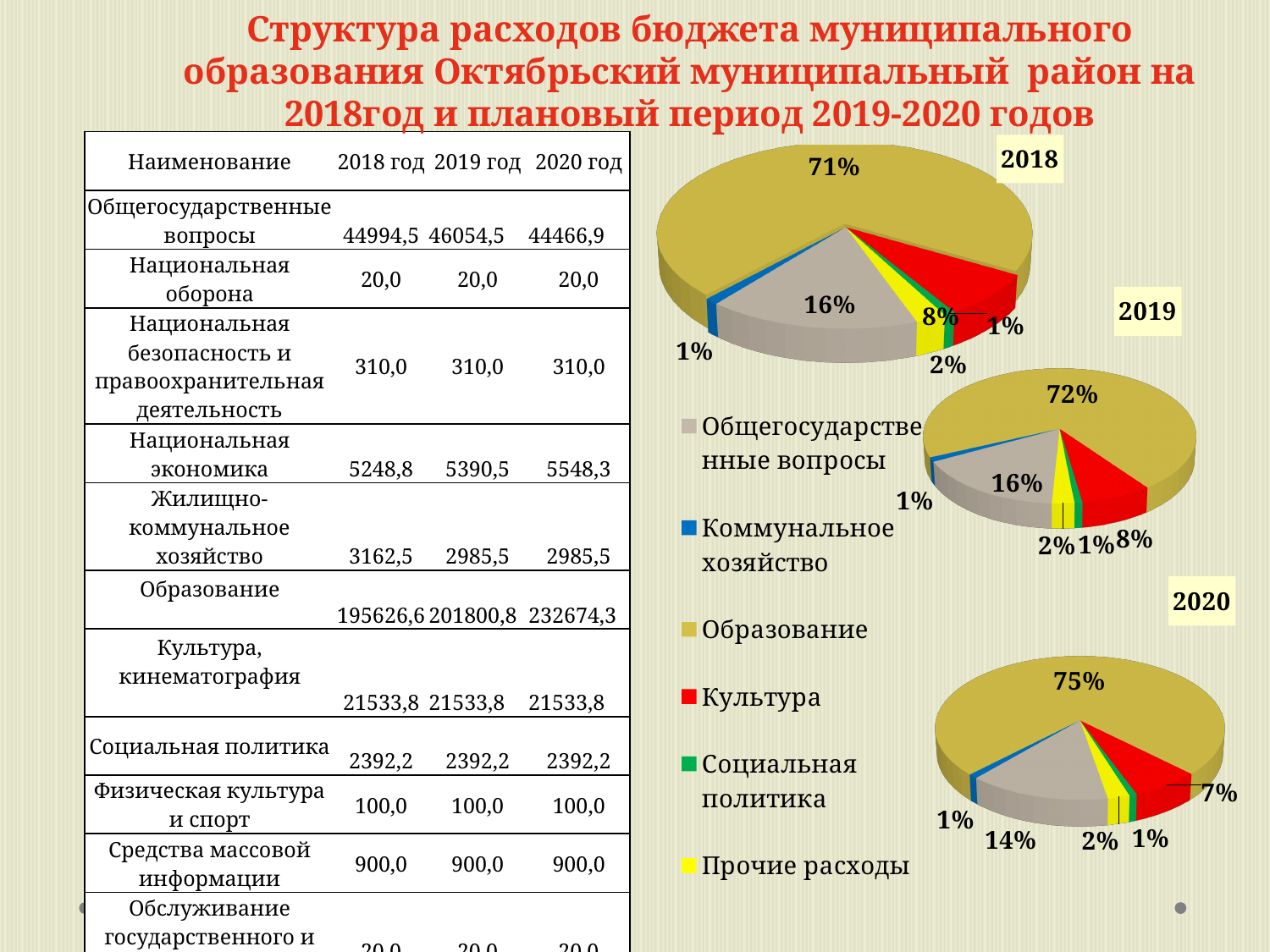
In the 2020 pie chart, what share is shown for Общегосударственные вопросы? 14% In the 2020 pie chart, what is the difference in percentage points between the Образование slice and the Общегосударственные вопросы slice? 61 percentage points In the 2020 pie chart, which category has the largest slice? Образование In the 2019 pie chart, what share is shown for Образование? 72% In the 2018 pie chart, what share is shown for Образование? 71% What kind of charts are shown on the slide? Pie charts How many categories does the shared legend of the pie charts list? 6 In the 2018 pie chart, which is larger: the slice for Образование or the slice for Общегосударственные вопросы? Образование